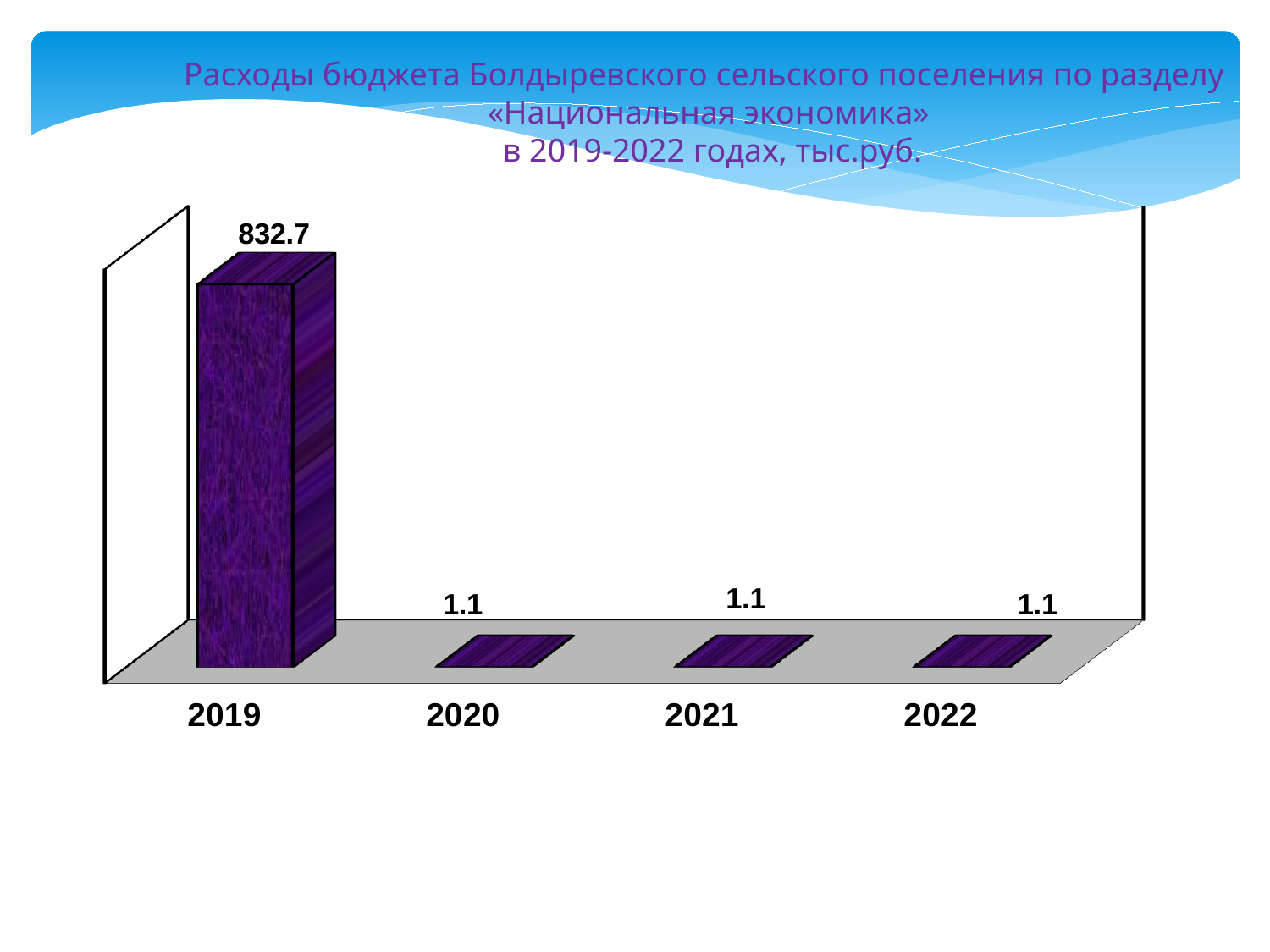
What is the value for 2020? 1.1 What is the total of the values for 2020, 2021 and 2022? 3.3 What kind of chart is this? bar chart In what units are the values given according to the chart title? тыс.руб. What is the value for 2019? 832.7 Do the values rise or fall from 2019 to 2020? fall Which is larger, the value for 2019 or the value for 2021? 2019 What is the difference between the values for 2019 and 2020? 831.6 What is the value for 2022? 1.1 Which year has the highest value? 2019 How many years are shown on the x axis? 4 Which budget section does the chart title refer to? «Национальная экономика»